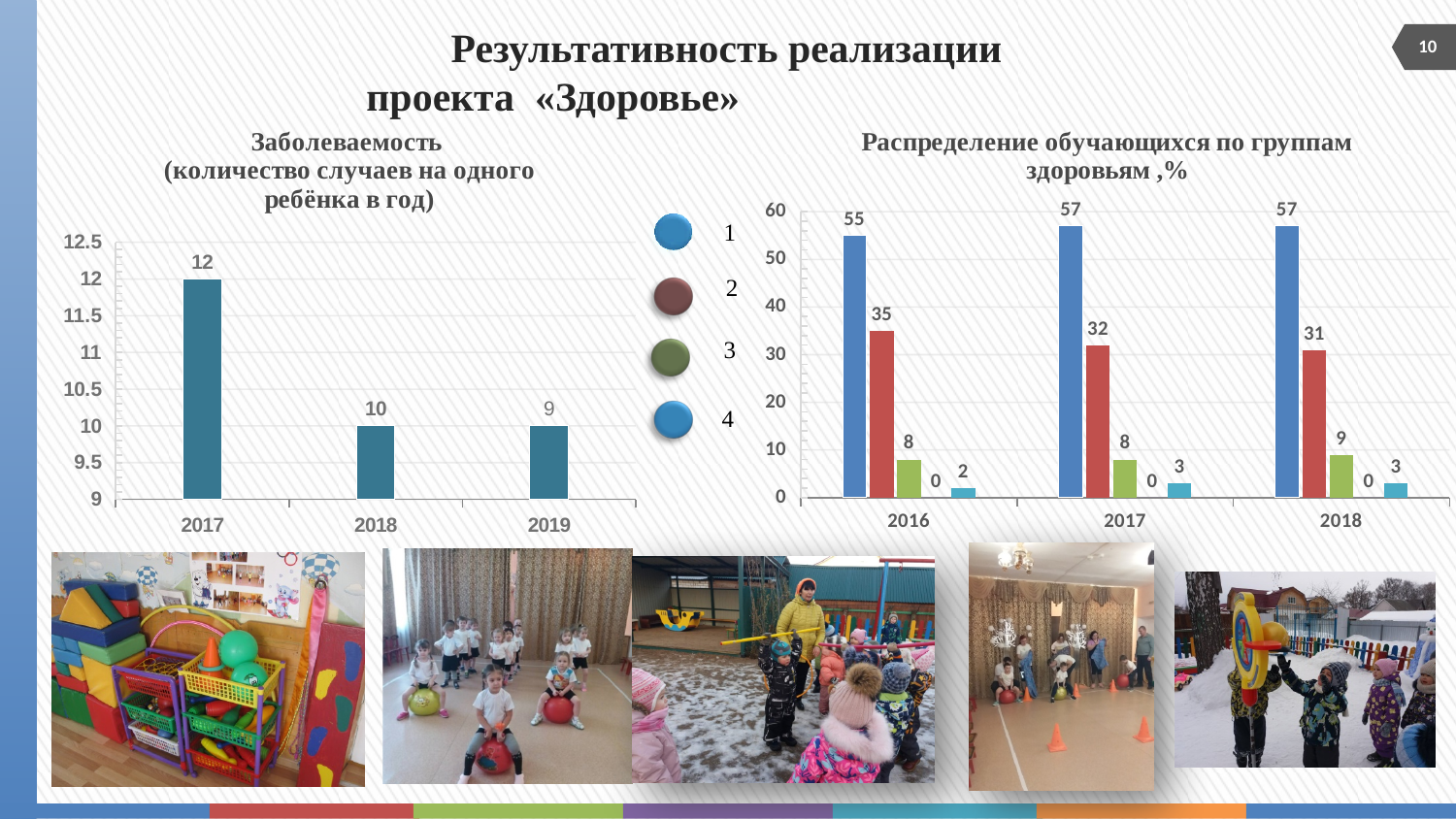
In the left chart (Заболеваемость), do the values rise or fall from 2017 to 2019? fall In the right chart (Распределение обучающихся по группам здоровьям), how many years are shown on the x axis? 3 In the right chart (Распределение обучающихся по группам здоровьям), what is the value of the red bar for 2018? 31 In the left chart (Заболеваемость), what is the value for 2017? 12 In the right chart (Распределение обучающихся по группам здоровьям), what is the difference between the red bar values for 2016 and 2018? 4 In the right chart (Распределение обучающихся по группам здоровьям), what is the value of the blue bar for 2016? 55 What kind of chart is the left chart (Заболеваемость)? bar chart In the right chart (Распределение обучающихся по группам здоровьям), in which year is the red bar highest? 2016 In the right chart (Распределение обучающихся по группам здоровьям), what is the value of the green bar for 2018? 9